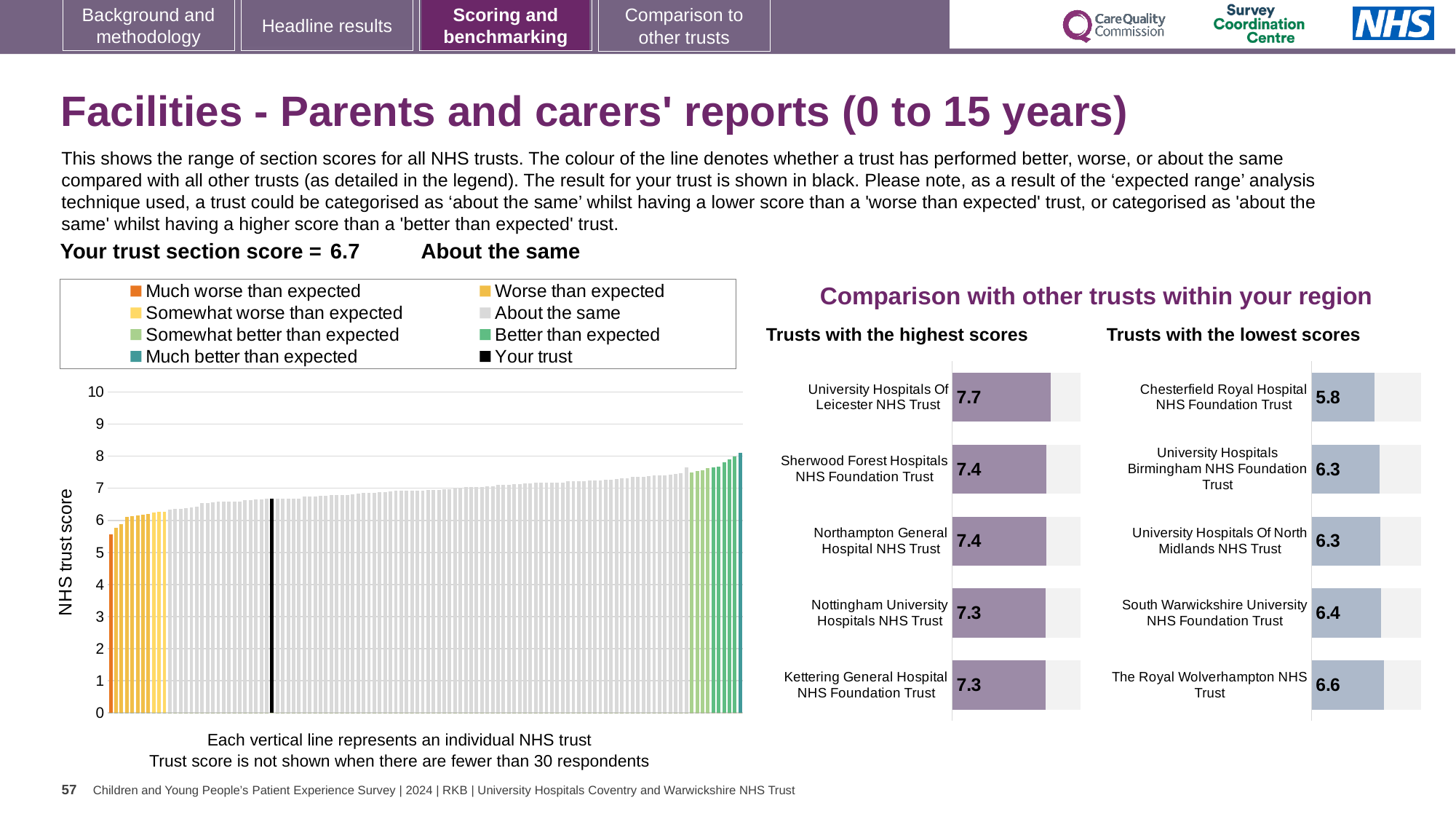
In the 'Trusts with the highest scores' chart, what is the difference between the scores of University Hospitals Of Leicester NHS Trust and Kettering General Hospital NHS Foundation Trust? 0.4 In the 'Trusts with the lowest scores' chart, which trust has the lowest score? Chesterfield Royal Hospital NHS Foundation Trust What is the y-axis label of the large chart on the left? NHS trust score What kind of chart is the large chart on the left showing NHS trust scores? Bar chart In the 'Trusts with the highest scores' chart, which trust has the highest score? University Hospitals Of Leicester NHS Trust How many entries does the legend of the large chart on the left list? 8 In the 'Trusts with the highest scores' chart, what is the score for University Hospitals Of Leicester NHS Trust? 7.7 In the 'Trusts with the lowest scores' chart, what is the score for Chesterfield Royal Hospital NHS Foundation Trust? 5.8 In the large chart on the left, is the value for 'Your trust' greater or less than 6? greater In the 'Trusts with the lowest scores' chart, what is the difference between the scores of The Royal Wolverhampton NHS Trust and Chesterfield Royal Hospital NHS Foundation Trust? 0.8 In the 'Trusts with the lowest scores' chart, which has the higher score: South Warwickshire University NHS Foundation Trust or Chesterfield Royal Hospital NHS Foundation Trust? South Warwickshire University NHS Foundation Trust How many trusts are listed in the 'Trusts with the highest scores' chart? 5